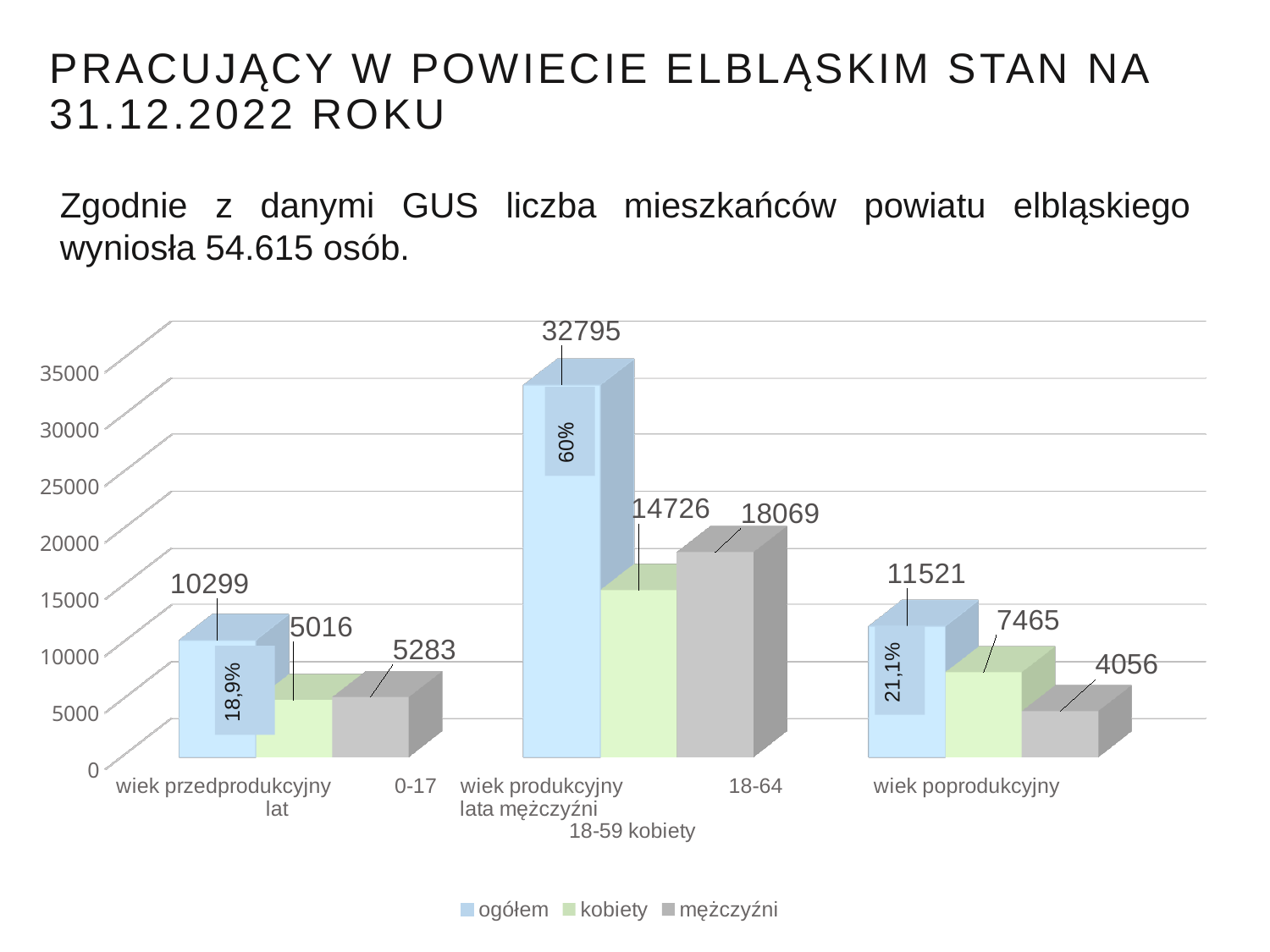
What kind of chart is shown on the slide? bar chart What is the value of the 'kobiety' series for 'wiek poprodukcyjny'? 7465 For 'wiek poprodukcyjny', which is larger: the 'kobiety' value or the 'mężczyźni' value? kobiety How many series does the legend list? 3 How many categories are shown on the x axis? 3 What is the difference between the 'ogółem' values for 'wiek poprodukcyjny' and 'wiek przedprodukcyjny'? 1222 Which category has the lowest 'mężczyźni' value? wiek poprodukcyjny What is the value of the 'mężczyźni' series for 'wiek przedprodukcyjny'? 5283 Which category has the highest 'ogółem' value? wiek produkcyjny What is the difference between the 'mężczyźni' and 'kobiety' values for 'wiek produkcyjny'? 3343 What is the value of the 'ogółem' series for 'wiek produkcyjny'? 32795 What percentage label is shown on the 'ogółem' bar for 'wiek poprodukcyjny'? 21,1%